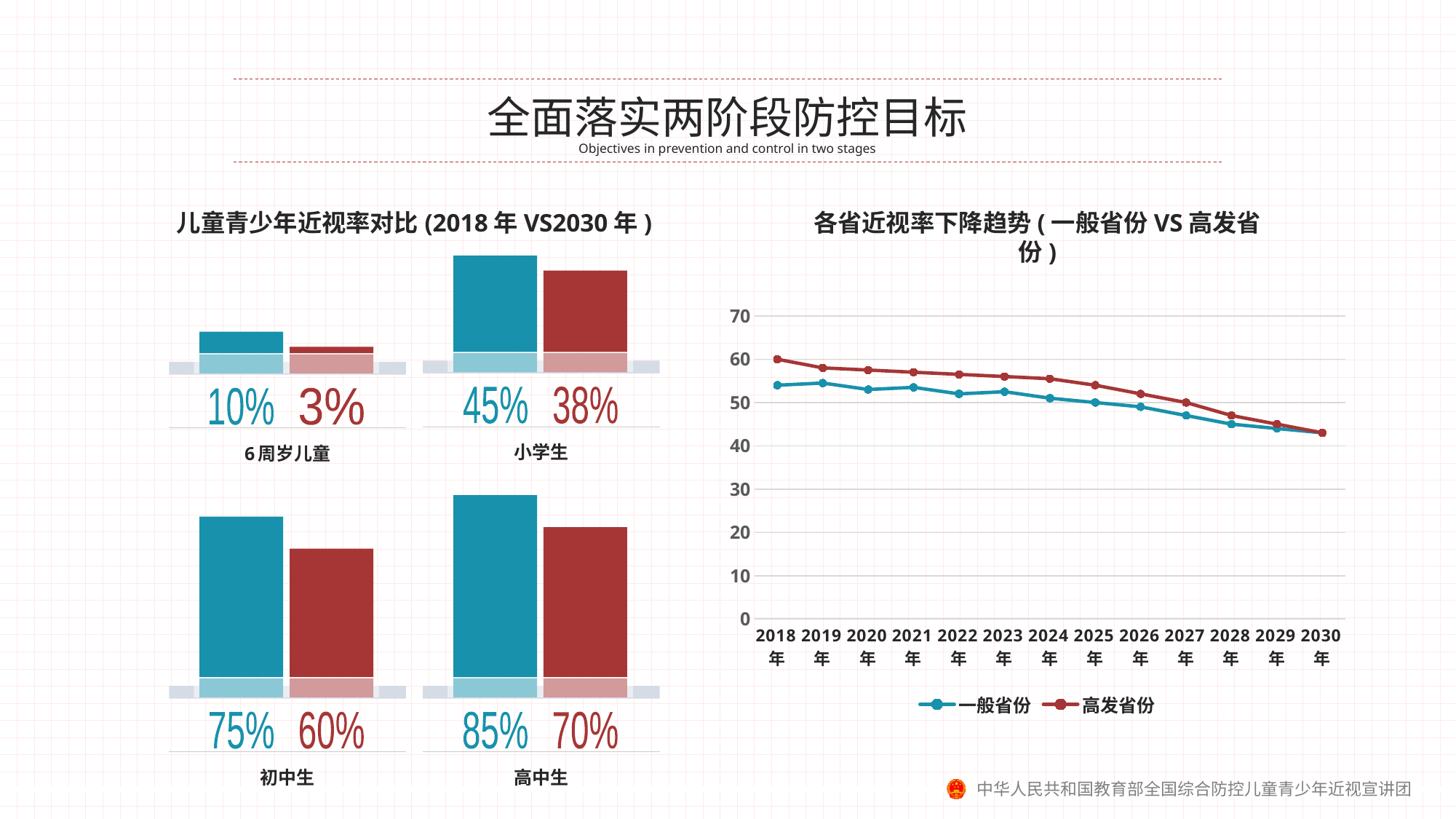
In the left chart '儿童青少年近视率对比 (2018 年 VS2030 年)', what is the difference between the 2018 and 2030 values for 初中生? 15% In the left chart '儿童青少年近视率对比 (2018 年 VS2030 年)', what is the 2018 value for 小学生? 45% In the left chart '儿童青少年近视率对比 (2018 年 VS2030 年)', what is the 2030 value for 6 周岁儿童? 3% In the left chart '儿童青少年近视率对比 (2018 年 VS2030 年)', how many groups are compared? 4 In the left chart '儿童青少年近视率对比 (2018 年 VS2030 年)', which group has the lowest 2030 value? 6 周岁儿童 What kind of chart is the right chart '各省近视率下降趋势 (一般省份 VS 高发省份)'? line chart In the right chart '各省近视率下降趋势 (一般省份 VS 高发省份)', is the value for 高发省份 in 2018 greater or less than 50? greater In the right chart '各省近视率下降趋势 (一般省份 VS 高发省份)', which series has the larger value in 2018, 一般省份 or 高发省份? 高发省份 In the right chart '各省近视率下降趋势 (一般省份 VS 高发省份)', do the values for 高发省份 rise or fall from 2018 to 2030? fall In the left chart '儿童青少年近视率对比 (2018 年 VS2030 年)', which group has the highest 2018 value? 高中生 In the left chart '儿童青少年近视率对比 (2018 年 VS2030 年)', what is the 2030 value for 高中生? 70% In the right chart '各省近视率下降趋势 (一般省份 VS 高发省份)', how many series does the legend list? 2